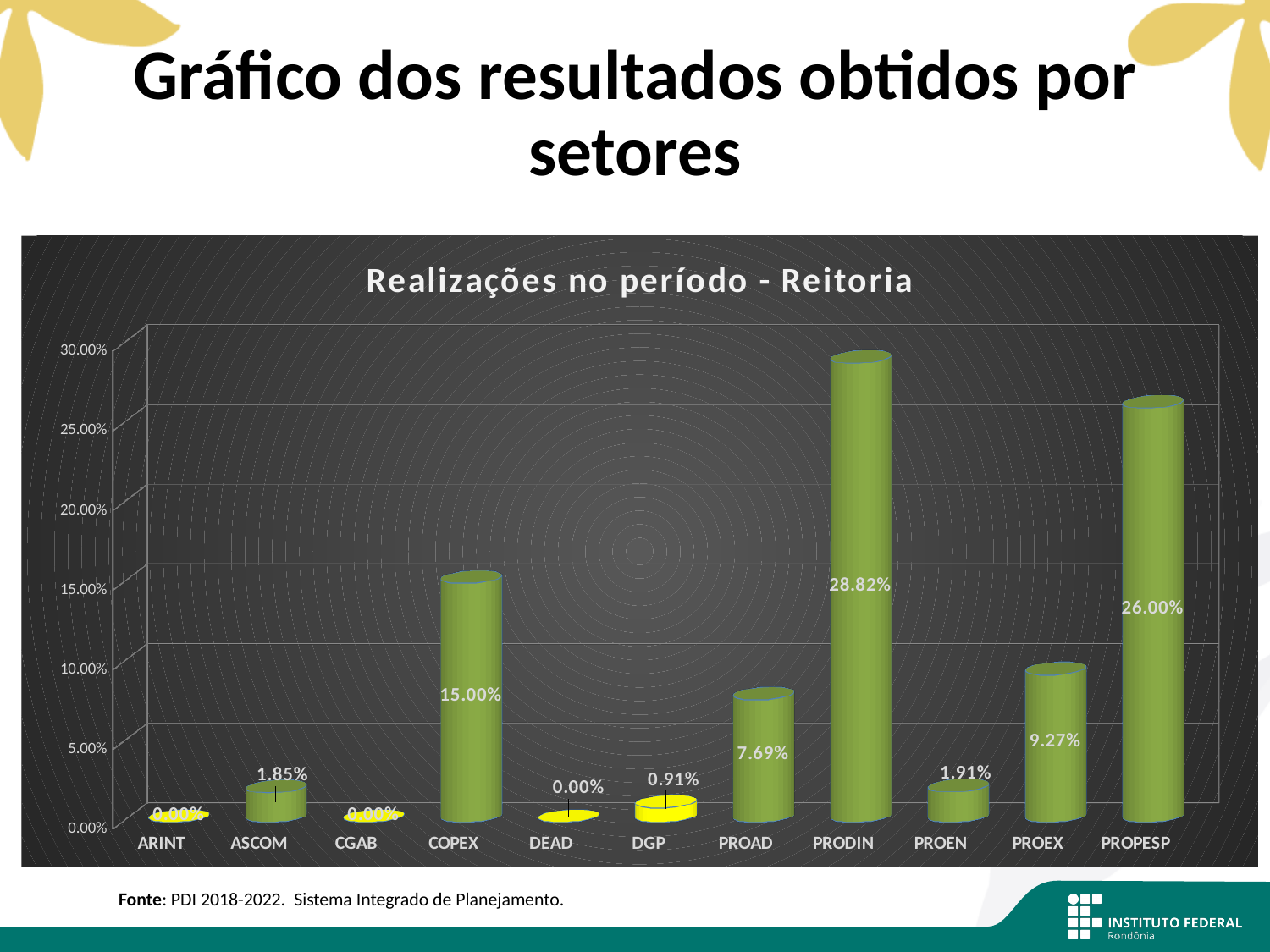
What is the value for DEAD in the chart? 0.00% Which sector has the highest value in the chart? PRODIN What is the value for PRODIN in the chart? 28.82% What is the difference between the values for PROEX and PROAD? 1.58% What is the title of the chart? Realizações no período - Reitoria What is the value for DGP in the chart? 0.91% What kind of chart is shown on the slide? bar chart Is the value for PROPESP greater or less than 25.00%? greater What is the value for COPEX in the chart? 15.00% How many sectors are shown on the x axis of the chart? 11 Which is larger, the value for PROAD or the value for PROEX? PROEX What is the difference between the values for PRODIN and PROPESP? 2.82%